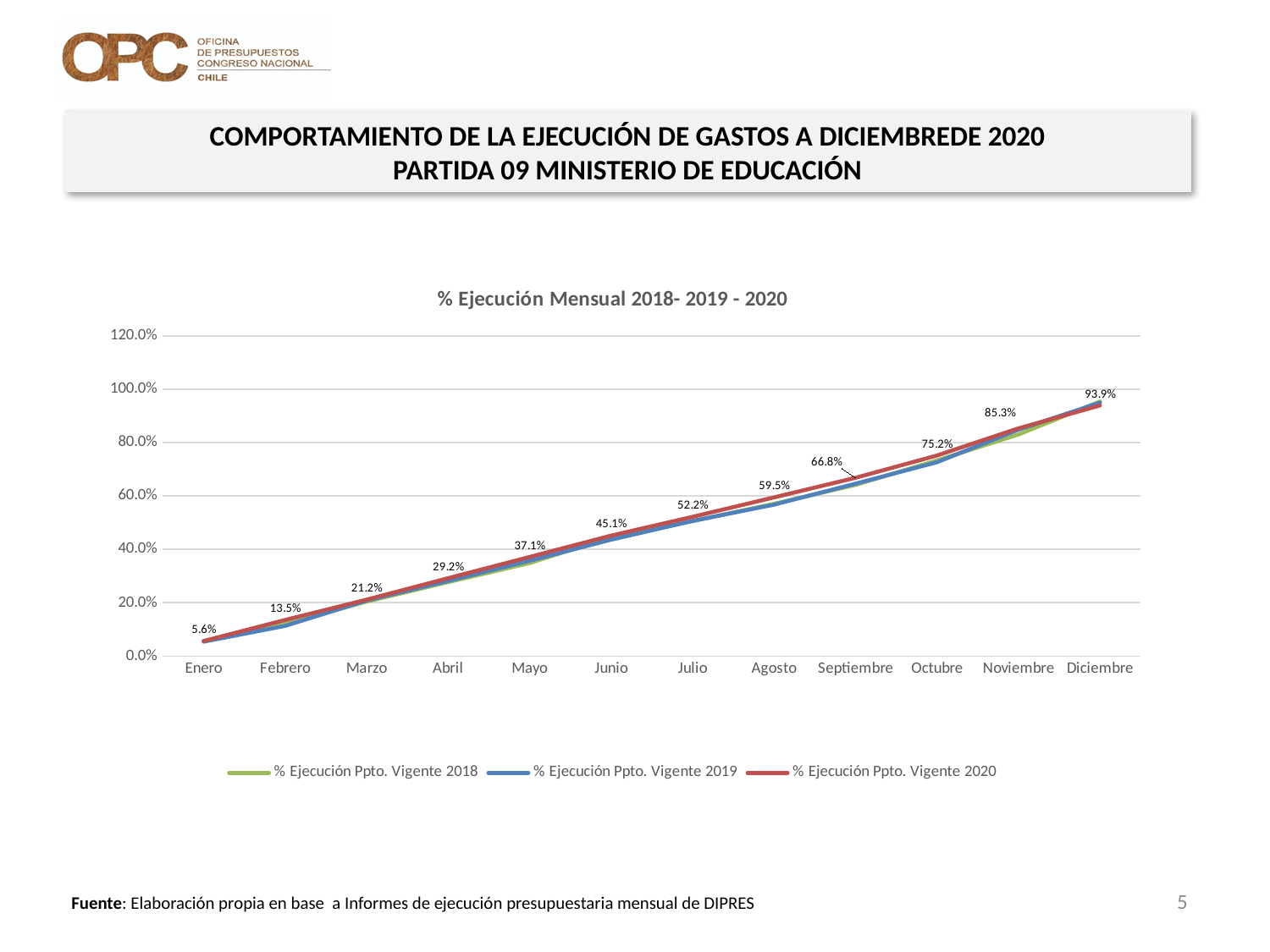
Is the value for % Ejecución Ppto. Vigente 2018 in Noviembre greater or less than 60.0%? greater What is the difference between the labelled values for Diciembre and Noviembre? 8.6% What value is labelled for Enero? 5.6% Do the plotted values rise or fall from Enero to Diciembre? rise How many months are plotted along the x axis? 12 What value is labelled for Septiembre? 66.8% What kind of chart is shown on the slide? line chart What value is labelled for Diciembre? 93.9% Which month has the highest labelled value? Diciembre What value is labelled for Junio? 45.1% What is the title of the chart? % Ejecución Mensual 2018- 2019 - 2020 How many series does the legend list? 3